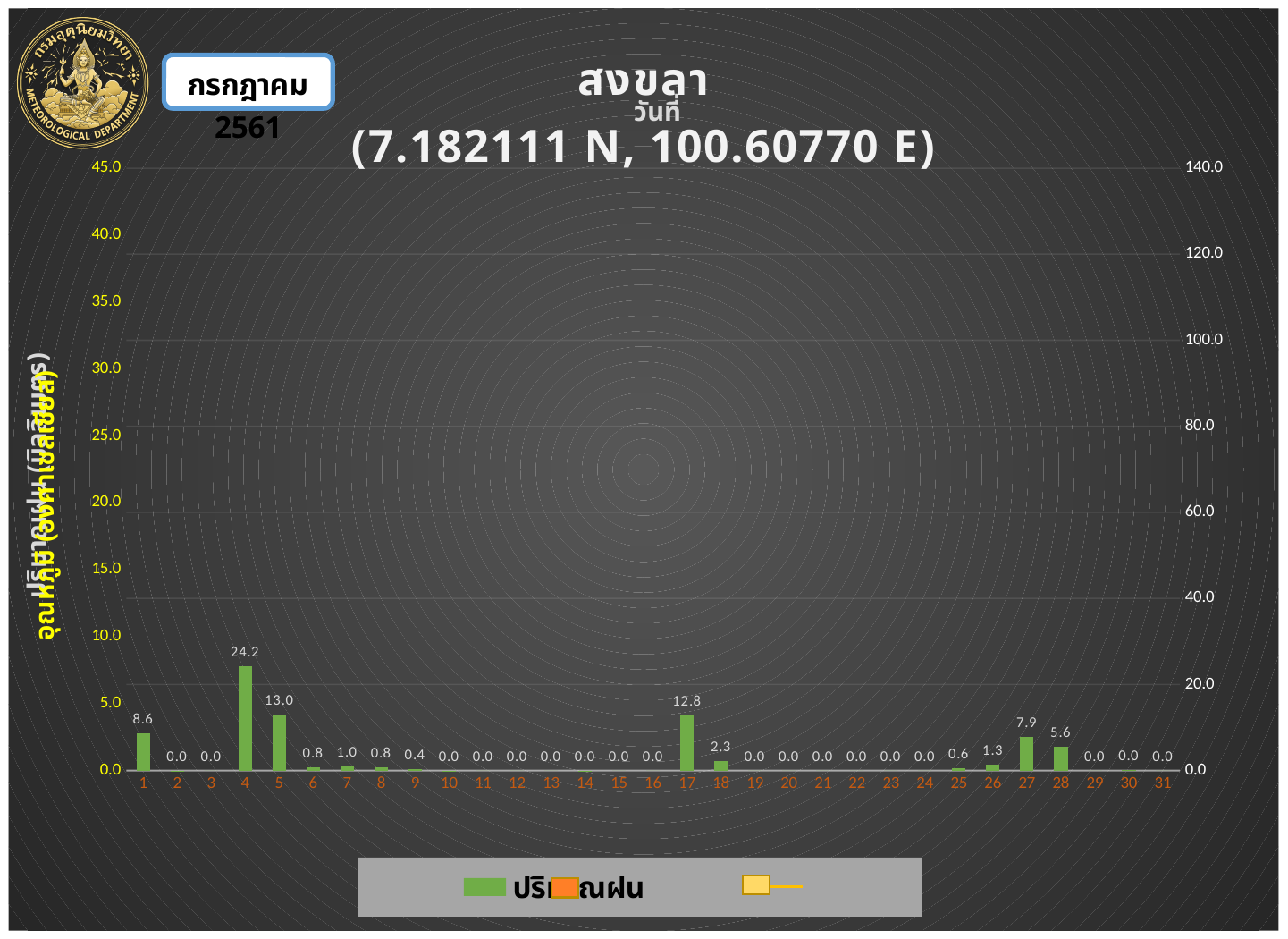
Which is larger, the value for day 27 or the value for day 28? day 27 What kind of chart is shown on the slide? bar chart How many days (categories) are shown on the x axis? 31 What is the difference between the values for day 4 and day 5? 11.2 What is the value shown for day 17? 12.8 What is the rainfall value shown for day 4? 24.2 What is the value shown for day 27? 7.9 Which is larger, the value for day 5 or the value for day 17? day 5 What is the value shown for day 1? 8.6 Which day has the highest value? 4 What is the difference between the values for day 17 and day 18? 10.5 What coordinates are given in the chart title? 7.182111 N, 100.60770 E